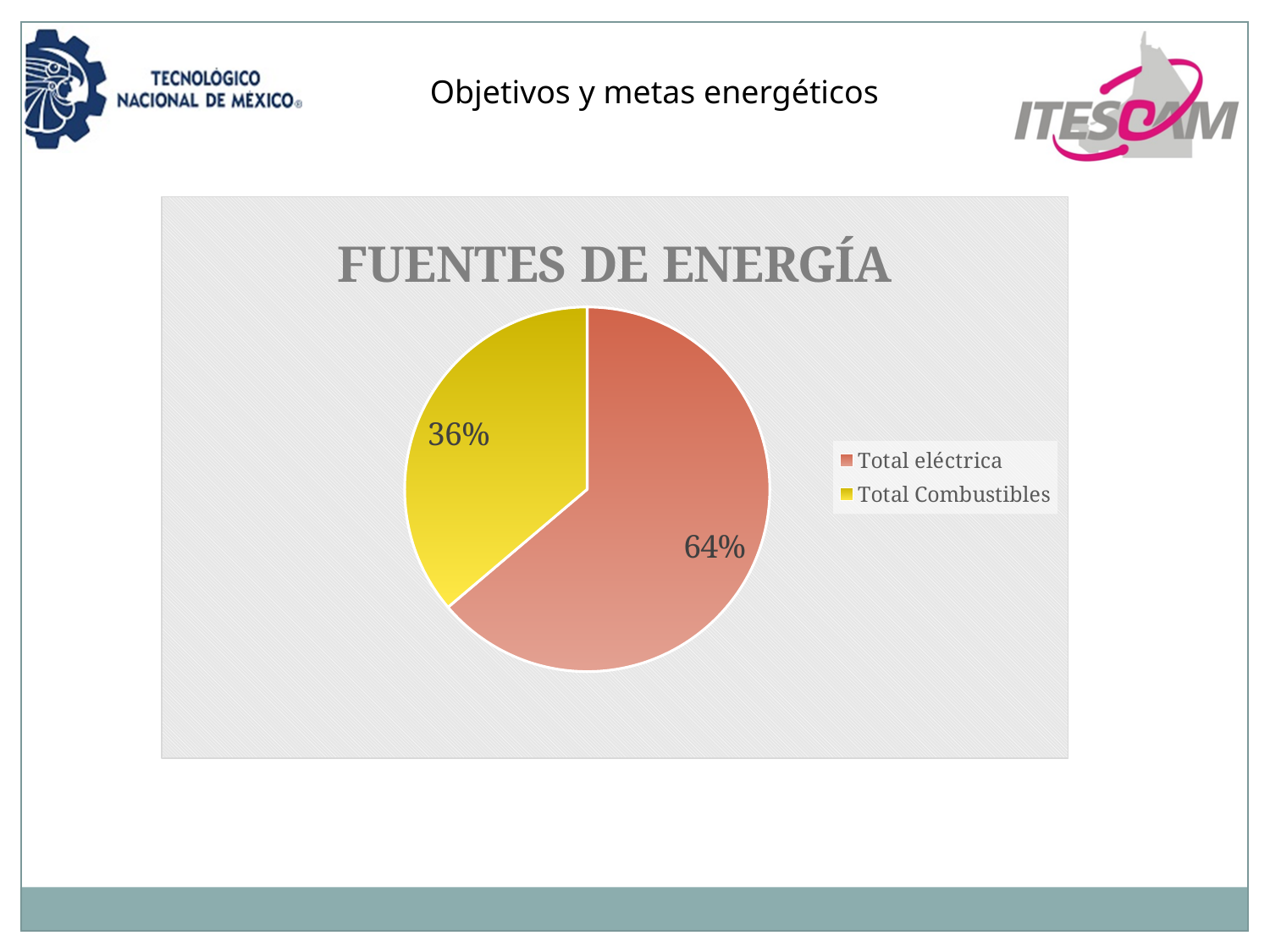
Which category has the smallest share of the pie? Total Combustibles Which category has the largest share of the pie? Total eléctrica What percentage of the pie is Total eléctrica? 64% How many entries does the legend list? 2 Which is larger, the share for Total eléctrica or the share for Total Combustibles? Total eléctrica What kind of chart is shown on the slide? Pie chart What is the difference in percentage points between Total eléctrica and Total Combustibles? 28 What is the title of the chart? FUENTES DE ENERGÍA What percentage of the pie is Total Combustibles? 36% Is the share for Total eléctrica greater or less than 50%? greater How many slices does the pie chart have? 2 What colour is the Total Combustibles slice? Yellow